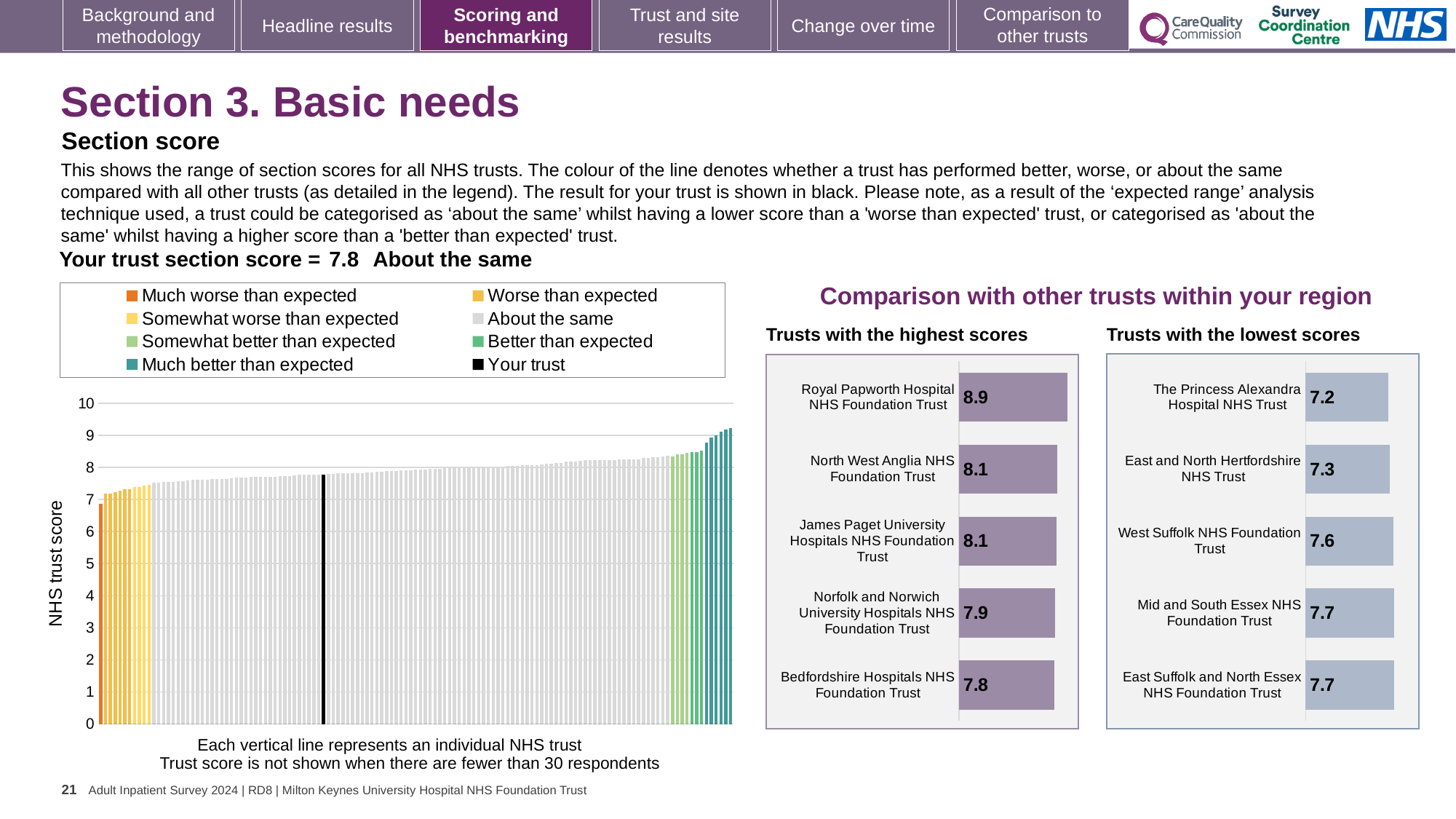
In the 'Trusts with the highest scores' chart, what is the difference between the scores of Royal Papworth Hospital NHS Foundation Trust and Bedfordshire Hospitals NHS Foundation Trust? 1.1 In the large chart on the left, is the value of the black bar representing your trust greater or less than 7? greater In the 'Trusts with the lowest scores' chart, which trust has the lowest score? The Princess Alexandra Hospital NHS Trust In the 'Trusts with the highest scores' chart, which trust has the lowest score shown? Bedfordshire Hospitals NHS Foundation Trust In the large chart on the left, how many entries does the legend list? 8 In the 'Trusts with the lowest scores' chart, what is the difference between the scores of West Suffolk NHS Foundation Trust and The Princess Alexandra Hospital NHS Trust? 0.4 In the 'Trusts with the highest scores' chart, how many trusts are listed? 5 In the 'Trusts with the lowest scores' chart, what is the score for West Suffolk NHS Foundation Trust? 7.6 In the 'Trusts with the lowest scores' chart, which is larger: the score for West Suffolk NHS Foundation Trust or East and North Hertfordshire NHS Trust? West Suffolk NHS Foundation Trust In the large chart on the left showing NHS trust scores, what kind of chart is it? Bar chart In the large chart on the left, do the trust scores rise or fall from left to right? Rise In the 'Trusts with the highest scores' chart, what is the score for Royal Papworth Hospital NHS Foundation Trust? 8.9